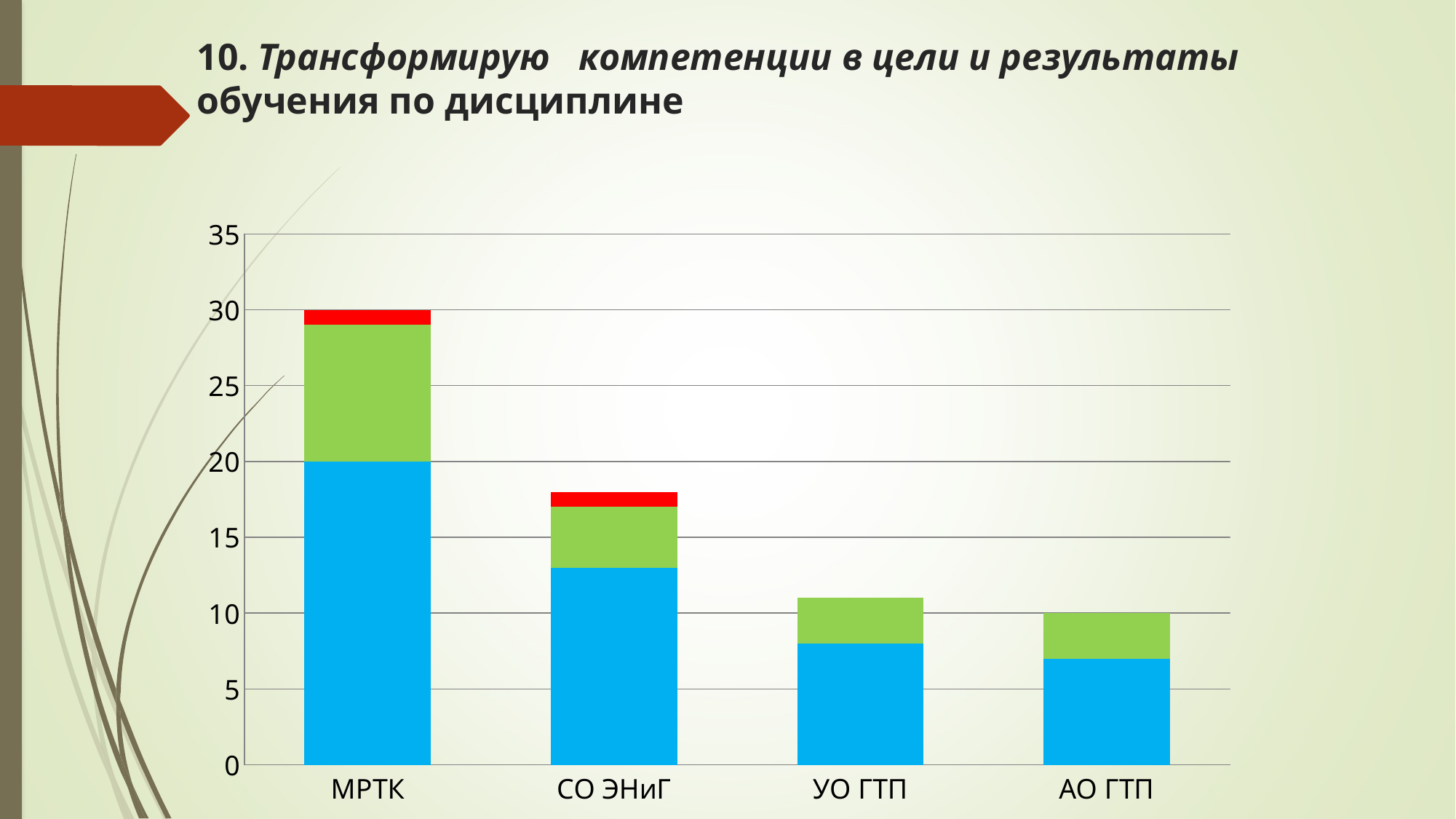
Which category has the shortest stacked bar? АО ГТП What kind of chart is shown on the slide? bar chart Which bar is taller, МРТК or СО ЭНиГ? МРТК Is the total height of the bar for СО ЭНиГ greater or less than 20? less How many categories are shown on the x axis of the chart? 4 Do the total bar heights rise or fall from left to right along the x axis? fall Which category has the tallest stacked bar? МРТК What value does the blue segment of the МРТК bar reach? 20 What is the total height of the stacked bar for АО ГТП? 10 What is the total height of the stacked bar for МРТК? 30 Is the total height of the bar for УО ГТП greater or less than 10? greater What is the difference between the total bar heights of МРТК and АО ГТП? 20